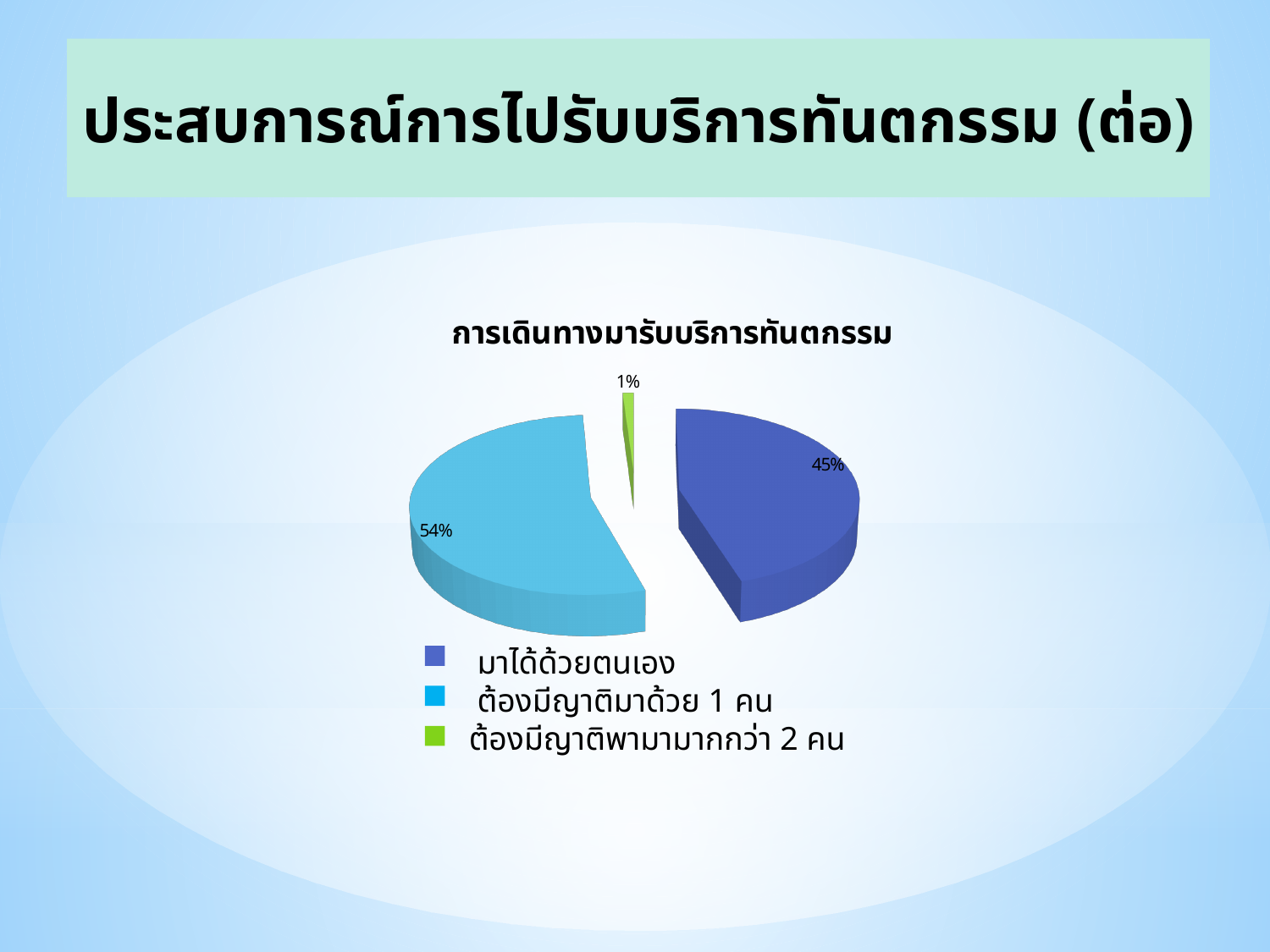
What is the difference in percentage points between ต้องมีญาติมาด้วย 1 คน and มาได้ด้วยตนเอง? 9 What colour is the slice for ต้องมีญาติพามามากกว่า 2 คน? Green Which category has the largest slice of the pie? ต้องมีญาติมาด้วย 1 คน What kind of chart is shown on the slide? Pie chart What share of the pie does ต้องมีญาติพามามากกว่า 2 คน represent? 1% How many categories does the pie chart have? 3 Which is larger: the share for มาได้ด้วยตนเอง or the share for ต้องมีญาติมาด้วย 1 คน? ต้องมีญาติมาด้วย 1 คน What share of the pie does ต้องมีญาติมาด้วย 1 คน represent? 54% What is the title of the chart? การเดินทางมารับบริการทันตกรรม What share of the pie does มาได้ด้วยตนเอง represent? 45% What is the difference in percentage points between มาได้ด้วยตนเอง and ต้องมีญาติพามามากกว่า 2 คน? 44 Which category has the smallest slice of the pie? ต้องมีญาติพามามากกว่า 2 คน